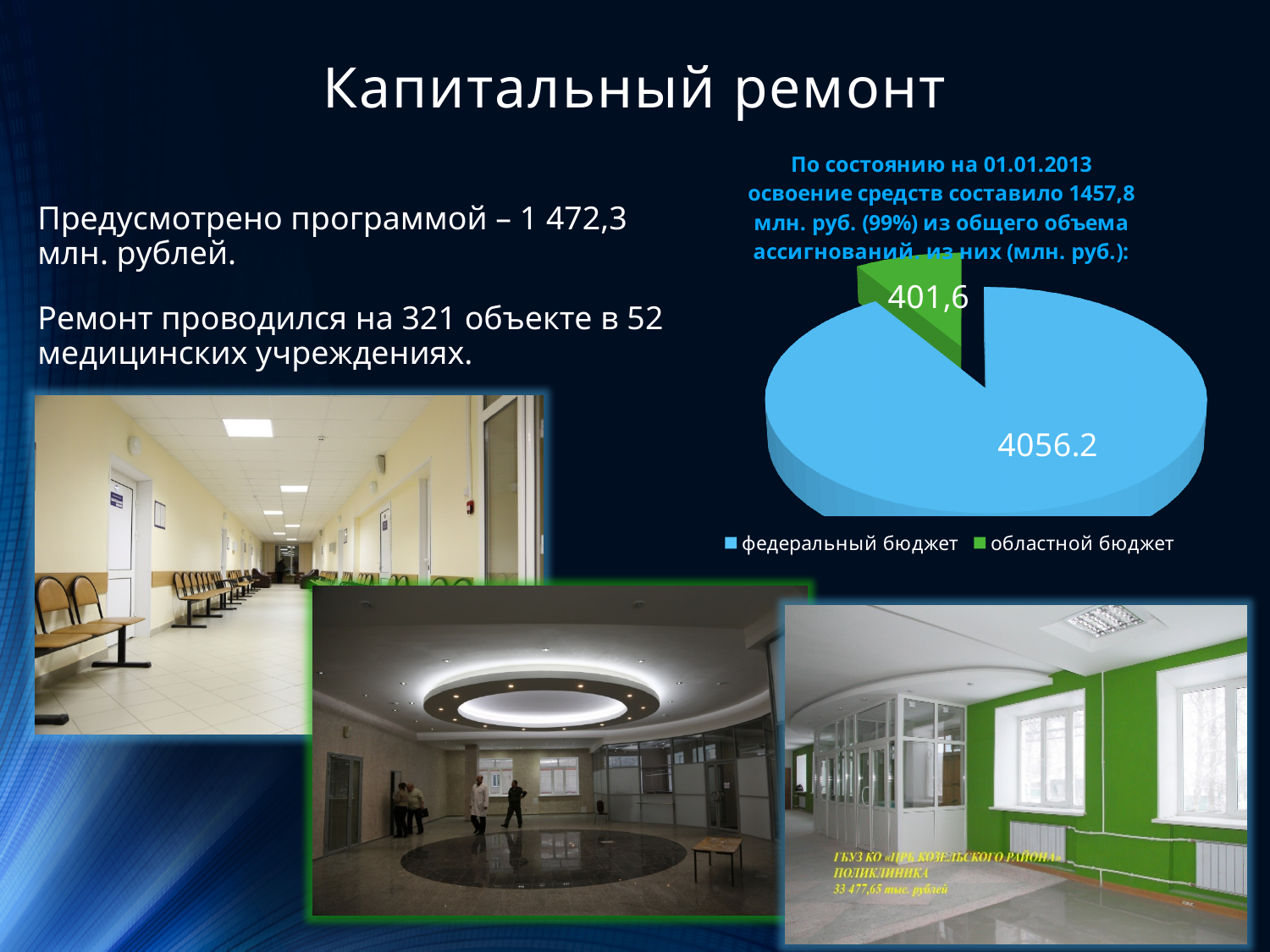
How many slices does the pie chart have? 2 Which is larger in the pie chart, федеральный бюджет or областной бюджет? федеральный бюджет What is the difference between the федеральный бюджет and областной бюджет values in the pie chart? 3654.6 Which slice of the pie chart is the smallest? областной бюджет How many entries does the legend of the pie chart list? 2 Which slice of the pie chart is the largest? федеральный бюджет What is the total of the two values shown in the pie chart? 4457.8 What value is shown for федеральный бюджет in the pie chart? 4056.2 What value is shown for областной бюджет in the pie chart? 401,6 What colour is the федеральный бюджет slice in the pie chart? blue What colour is the областной бюджет slice in the pie chart? green What kind of chart is shown on the slide? pie chart